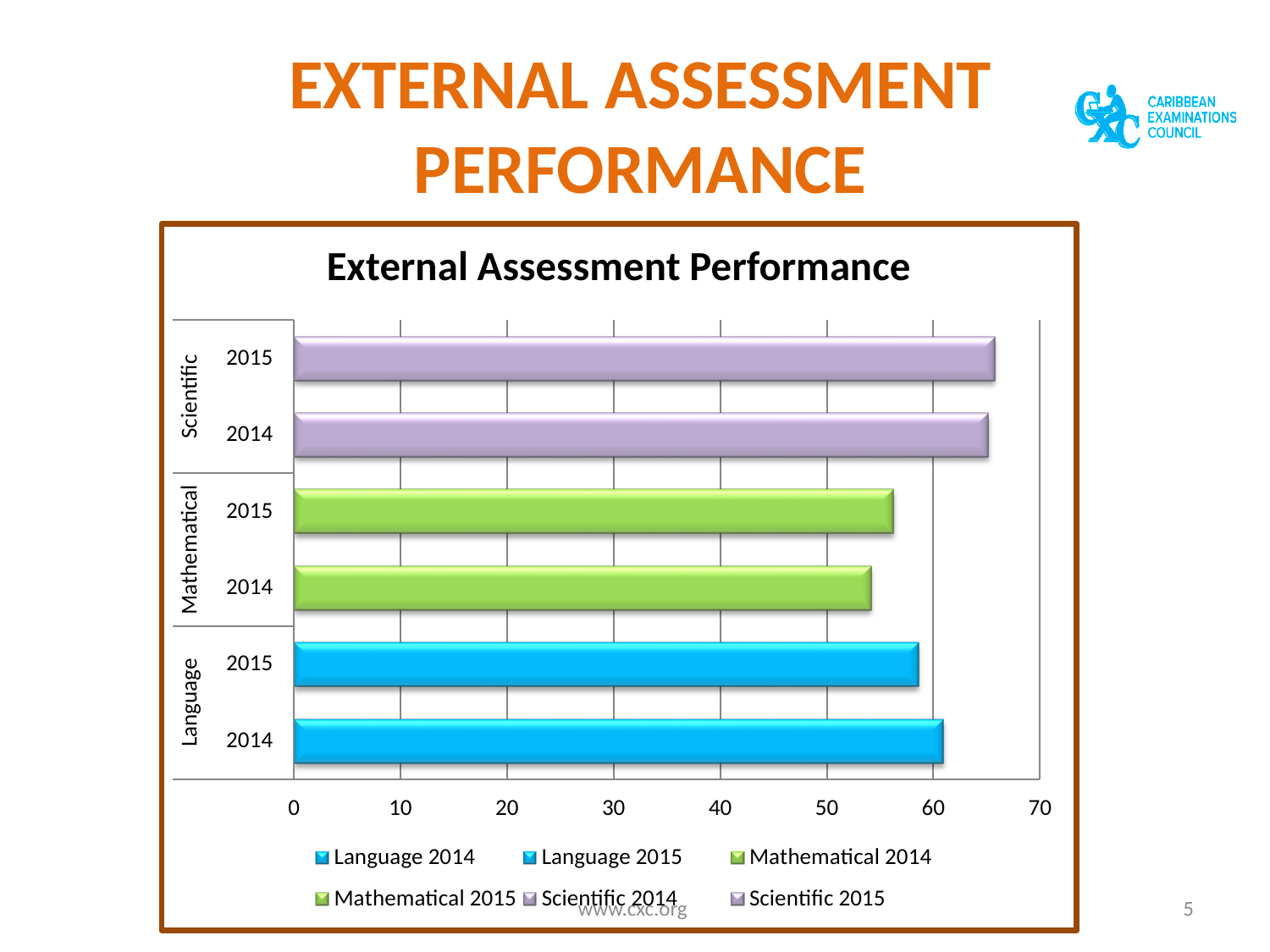
Which is larger, the value for Scientific 2014 or the value for Mathematical 2015? Scientific 2014 How many bars are plotted in the chart? 6 What is the title of the chart? External Assessment Performance How many series does the legend list? 6 Is the value for Mathematical 2015 greater or less than 60? less What colour are the bars for the Scientific series? purple Is the value for Language 2014 greater or less than 50? greater Which is larger, the value for Language 2014 or the value for Mathematical 2014? Language 2014 Is the value for Scientific 2015 greater or less than 60? greater What kind of chart is shown on the slide? bar chart